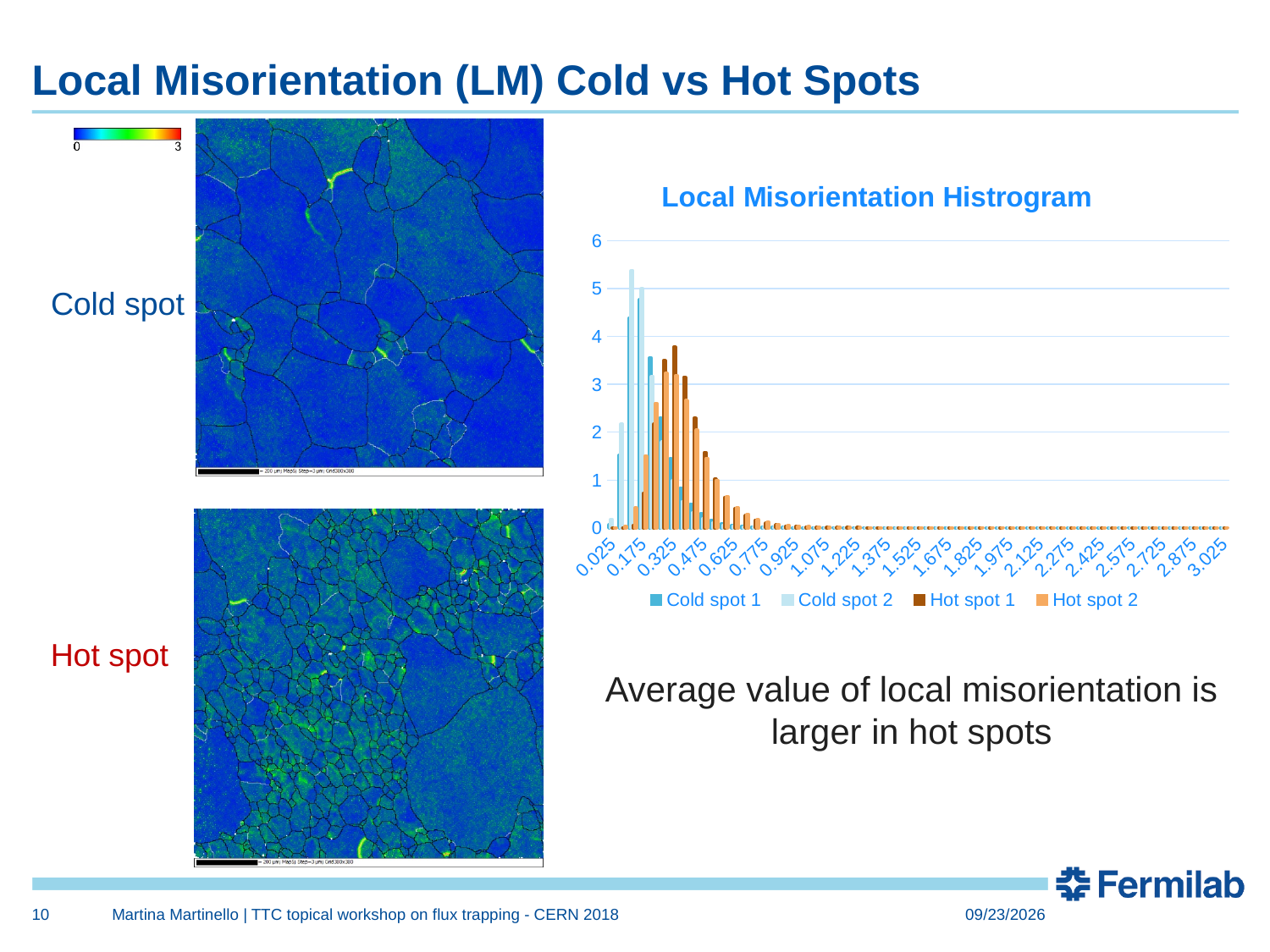
Which series reaches the highest value in the Local Misorientation Histogram? Cold spot 2 How many series does the legend of the Local Misorientation Histogram list? 4 How many x-axis labels are shown on the Local Misorientation Histogram? 21 What are the legend entries of the Local Misorientation Histogram? Cold spot 1, Cold spot 2, Hot spot 1, Hot spot 2 Is the peak value of Hot spot 1 in the Local Misorientation Histogram greater or less than 3? greater Is the peak value of Hot spot 1 in the Local Misorientation Histogram greater or less than 4? less In the Local Misorientation Histogram, which has a higher peak, Cold spot 2 or Hot spot 2? Cold spot 2 In the Local Misorientation Histogram, do the values for Hot spot 2 rise or fall from 0.475 to 0.775 along the x axis? fall What kind of chart is the Local Misorientation Histogram? bar chart Is the peak value of Cold spot 2 in the Local Misorientation Histogram greater or less than 5? greater What is the highest tick value on the y axis of the Local Misorientation Histogram? 6 What is the title of the chart on the slide? Local Misorientation Histrogram